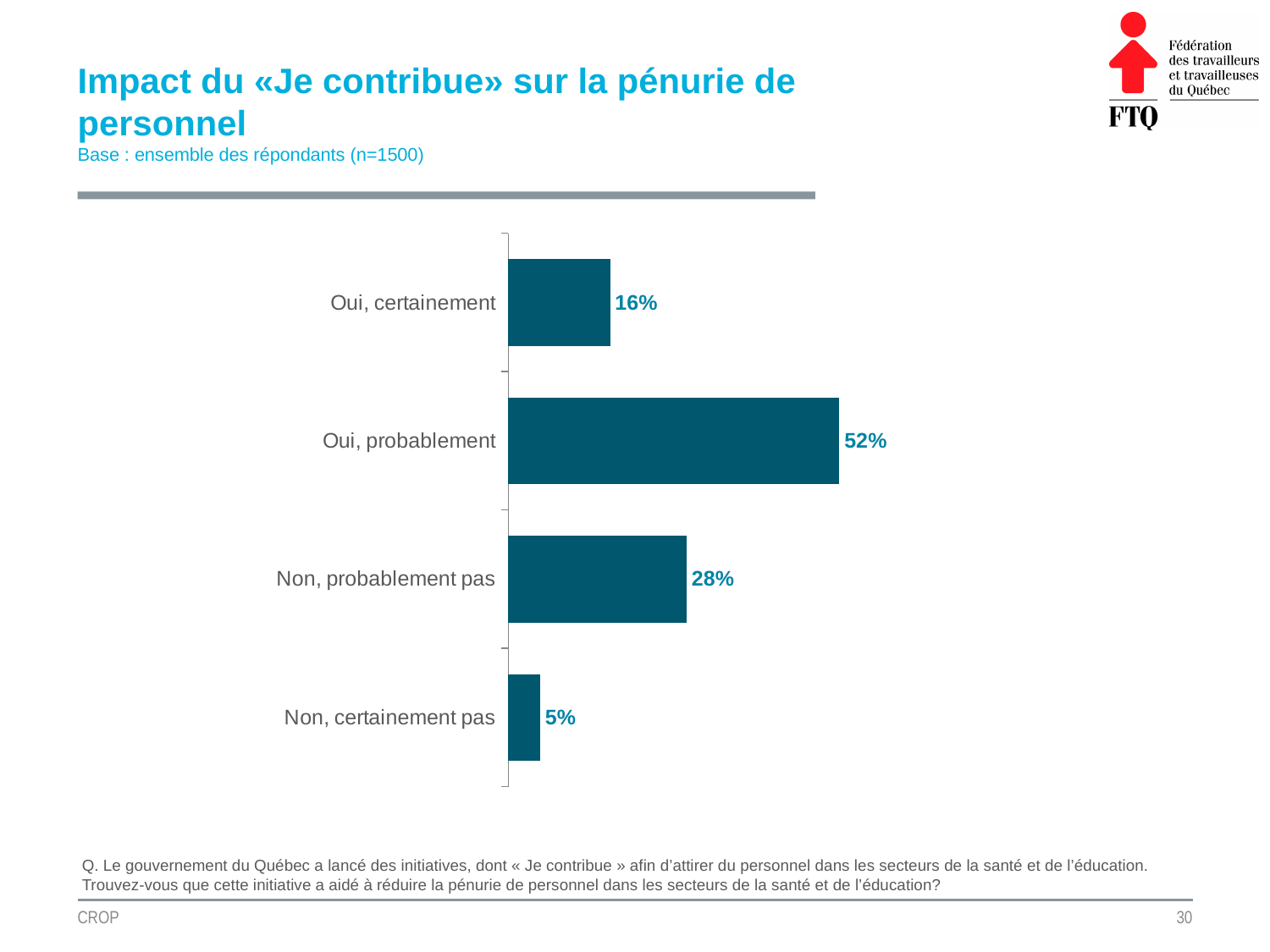
What is the difference between the values for "Oui, probablement" and "Non, probablement pas"? 24% What is the title of the slide containing the chart? Impact du «Je contribue» sur la pénurie de personnel Which is larger, the value for "Non, probablement pas" or the value for "Oui, certainement"? Non, probablement pas What is the value for "Non, certainement pas"? 5% Which category has the lowest value? Non, certainement pas How many categories are shown in the chart? 4 What is the difference between the values for "Oui, certainement" and "Non, certainement pas"? 11% What is the value for "Non, probablement pas"? 28% What is the value for "Oui, probablement"? 52% Which category has the highest value? Oui, probablement What kind of chart is shown on the slide? Bar chart What is the value for "Oui, certainement"? 16%